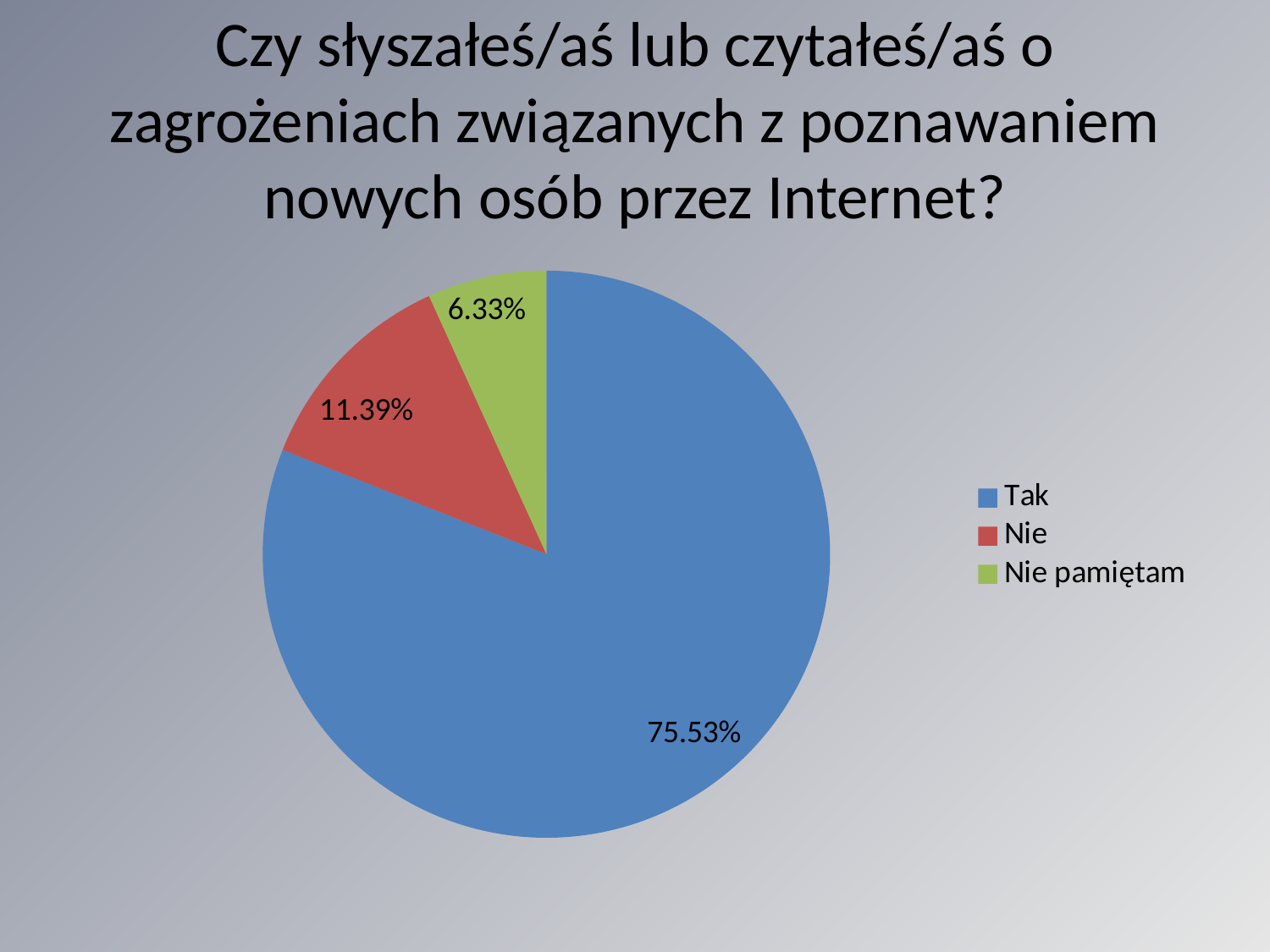
What kind of chart is shown on the slide? pie chart What colour is the slice for "Nie pamiętam"? green How many entries does the legend list? 3 What percentage of respondents answered "Nie pamiętam"? 6.33% Which is larger, the share for "Nie" or the share for "Nie pamiętam"? Nie What percentage of respondents answered "Nie"? 11.39% Which answer has the largest share of the pie? Tak What is the difference in percentage points between the "Tak" and "Nie" shares? 64.14 Which answer has the smallest share of the pie? Nie pamiętam What percentage of respondents answered "Tak"? 75.53% What is the difference in percentage points between the "Nie" and "Nie pamiętam" shares? 5.06 How many slices does the pie chart have? 3